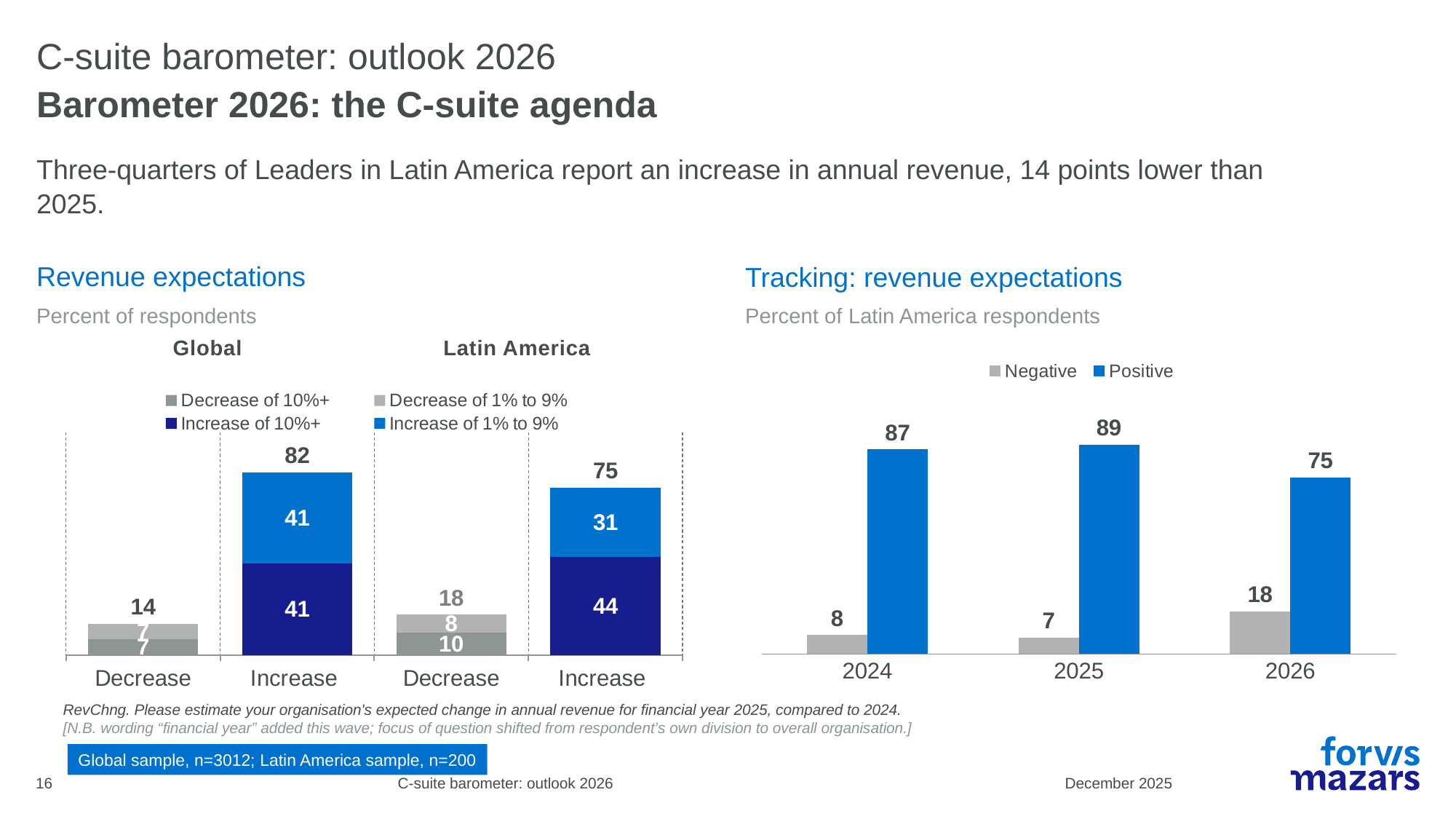
In the 'Tracking: revenue expectations' chart, does the Positive value rise or fall from 2025 to 2026? fall How many series does the legend of the 'Tracking: revenue expectations' chart list? 2 In the 'Tracking: revenue expectations' chart, what is the difference between the Positive values for 2025 and 2026? 14 In the 'Revenue expectations' chart, what is the total of the Latin America Increase bar? 75 In the 'Revenue expectations' chart, which Increase bar total is larger, Global or Latin America? Global How many years are shown on the x axis of the 'Tracking: revenue expectations' chart? 3 In the 'Tracking: revenue expectations' chart, what is the Positive value for 2025? 89 In the 'Tracking: revenue expectations' chart, which year has the highest Positive value? 2025 In the 'Revenue expectations' chart, what is the value for 'Increase of 1% to 9%' in the Global Increase bar? 41 In the 'Tracking: revenue expectations' chart, what is the Negative value for 2026? 18 In the 'Revenue expectations' chart, what is the value for 'Increase of 10%+' in the Latin America Increase bar? 44 What kind of chart is the 'Revenue expectations' chart? bar chart